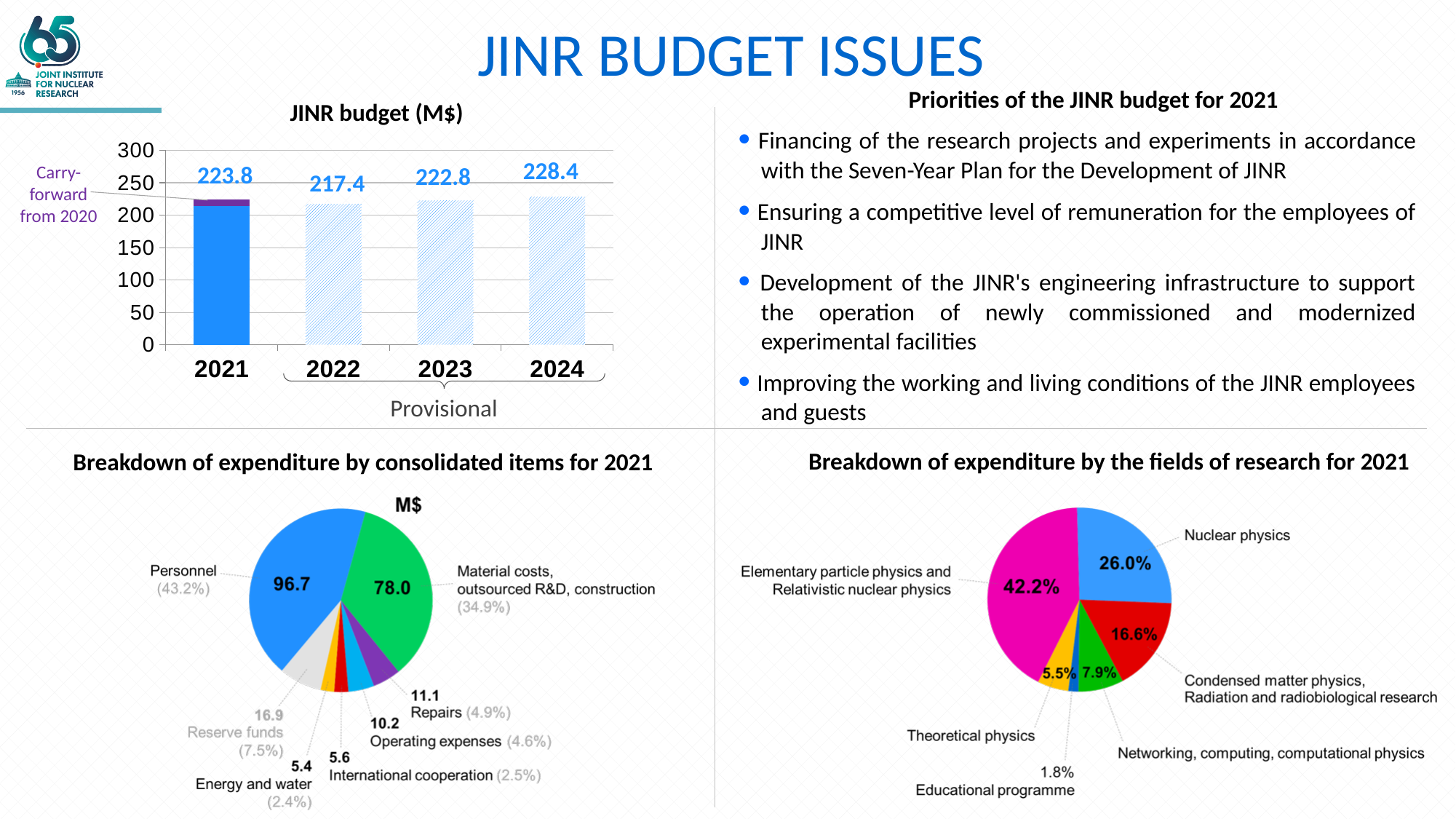
In the 'JINR budget (M$)' chart, what is the difference between the 2024 and 2022 values? 11.0 In the 'Breakdown of expenditure by the fields of research for 2021' pie chart, what share does Nuclear physics have? 26.0% In the 'JINR budget (M$)' chart, how many years are shown on the x axis? 4 What kind of chart is the 'JINR budget (M$)' chart? bar chart In the 'JINR budget (M$)' chart, which year has the lowest budget value? 2022 In the 'JINR budget (M$)' chart, is the value for 2023 greater or less than 200? greater In the 'Breakdown of expenditure by consolidated items for 2021' pie chart, which item has the smallest value? Energy and water In the 'Breakdown of expenditure by consolidated items for 2021' pie chart, what is the value in M$ for Personnel? 96.7 In the 'Breakdown of expenditure by the fields of research for 2021' pie chart, which field has the largest share? Elementary particle physics and Relativistic nuclear physics In the 'Breakdown of expenditure by consolidated items for 2021' pie chart, which is larger: Reserve funds or Operating expenses? Reserve funds In the 'Breakdown of expenditure by consolidated items for 2021' pie chart, what share does Repairs have? 4.9% In the 'JINR budget (M$)' chart, what is the budget value for 2024? 228.4